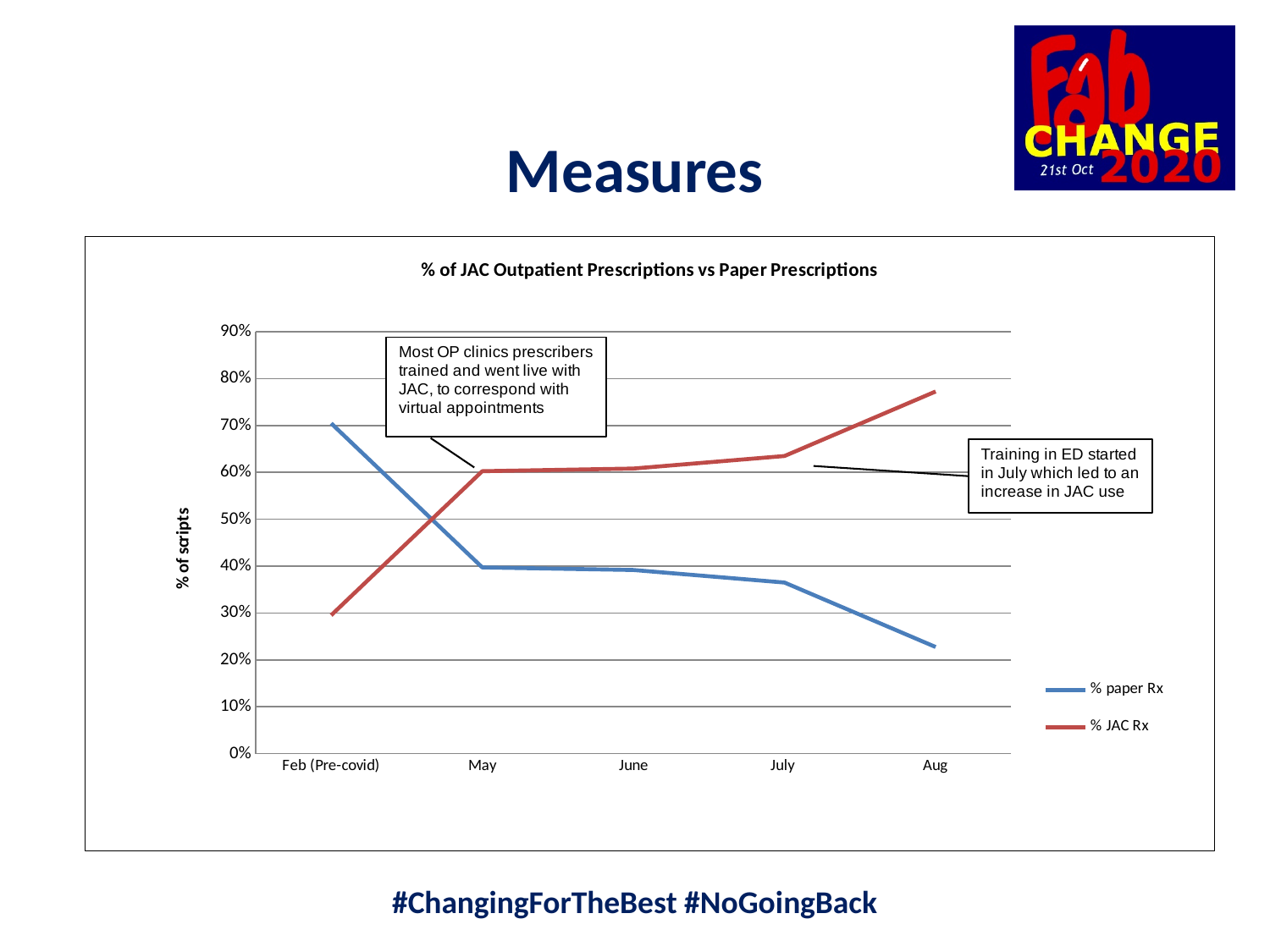
How many time points are plotted along the x axis? 5 In which month is % JAC Rx at its highest? Aug What kind of chart is shown on the slide? line chart Is the value for % JAC Rx in Aug greater or less than 70%? greater Does the % paper Rx series rise or fall from Feb (Pre-covid) to Aug? fall In which month is % paper Rx at its lowest? Aug In Feb (Pre-covid), which is larger: % paper Rx or % JAC Rx? % paper Rx What is the title of the chart? % of JAC Outpatient Prescriptions vs Paper Prescriptions Is the value for % paper Rx in July greater or less than 40%? less Which series is drawn in red? % JAC Rx Does the % JAC Rx series rise or fall from Feb (Pre-covid) to Aug? rise How many series does the legend list? 2